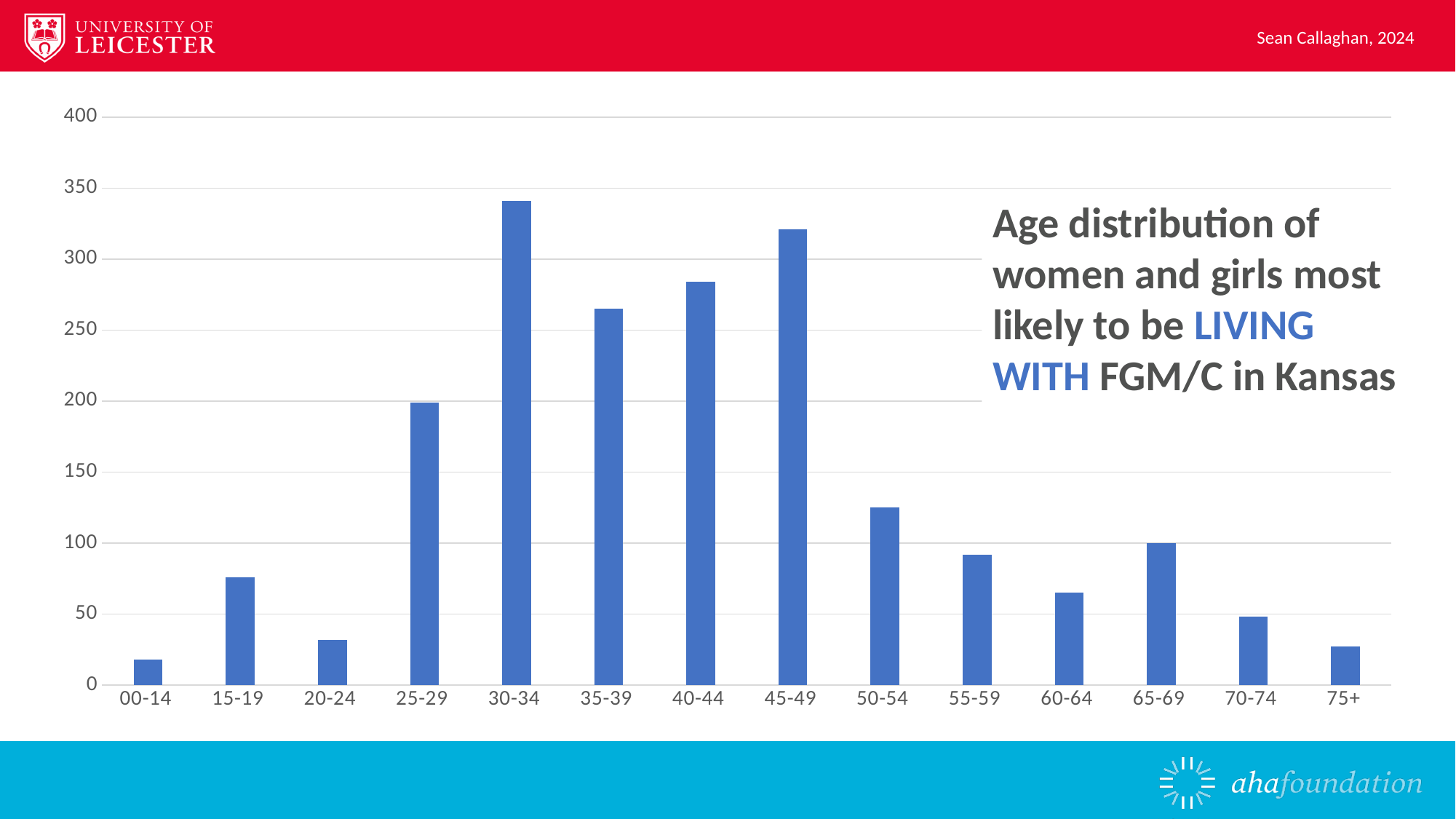
What is the title of the chart? Age distribution of women and girls most likely to be LIVING WITH FGM/C in Kansas Is the value for 40-44 greater or less than 300? less Is the value for 30-34 greater or less than 300? greater Which is larger, the value for 30-34 or the value for 45-49? 30-34 How many age groups are shown on the x axis? 14 Which age group has the lowest value? 00-14 What kind of chart is shown on the slide? bar chart Is the value for 50-54 greater or less than 100? greater Which is larger, the value for 15-19 or the value for 20-24? 15-19 Which age group has the highest value? 30-34 Do the values rise or fall from 50-54 to 60-64? fall